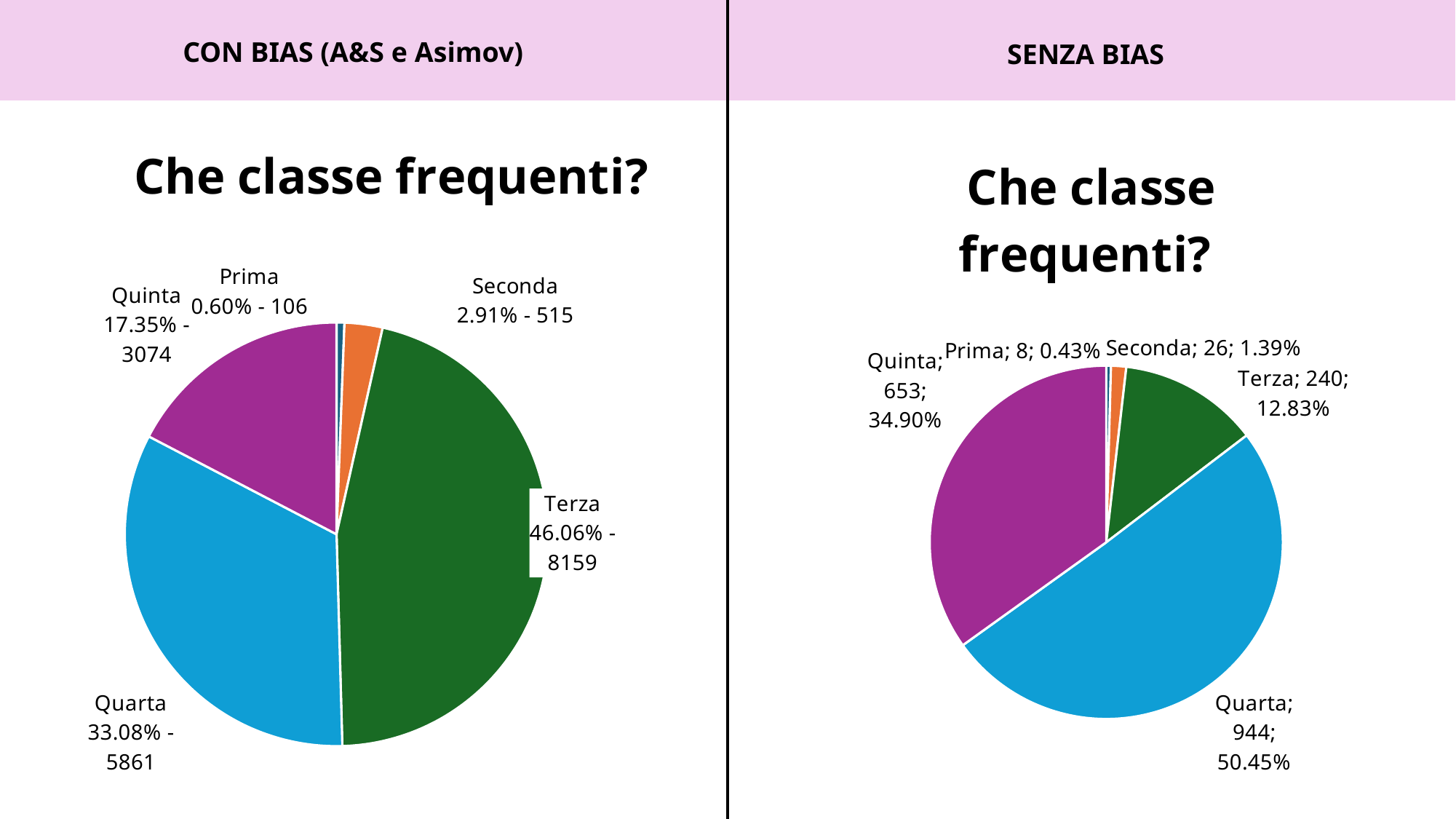
In the right pie chart (SENZA BIAS), what percentage of respondents attend Quinta? 34.90% In the left pie chart (CON BIAS), what is the difference in respondent count between Terza and Quarta? 2298 In the right pie chart (SENZA BIAS), how many respondents attend Terza? 240 In the right pie chart (SENZA BIAS), which class has the smallest share? Prima In the left pie chart (CON BIAS), which class has the largest share? Terza In the left pie chart (CON BIAS), which class has the smallest share? Prima In the right pie chart (SENZA BIAS), which class has the largest share? Quarta In the right pie chart (SENZA BIAS), which has more respondents, Quinta or Terza? Quinta In the left pie chart (CON BIAS), what percentage of respondents attend Terza? 46.06% What type of chart is used on the right side (SENZA BIAS)? Pie chart How many categories does the left pie chart (CON BIAS) show? 5 In the left pie chart (CON BIAS), how many respondents attend Quarta? 5861